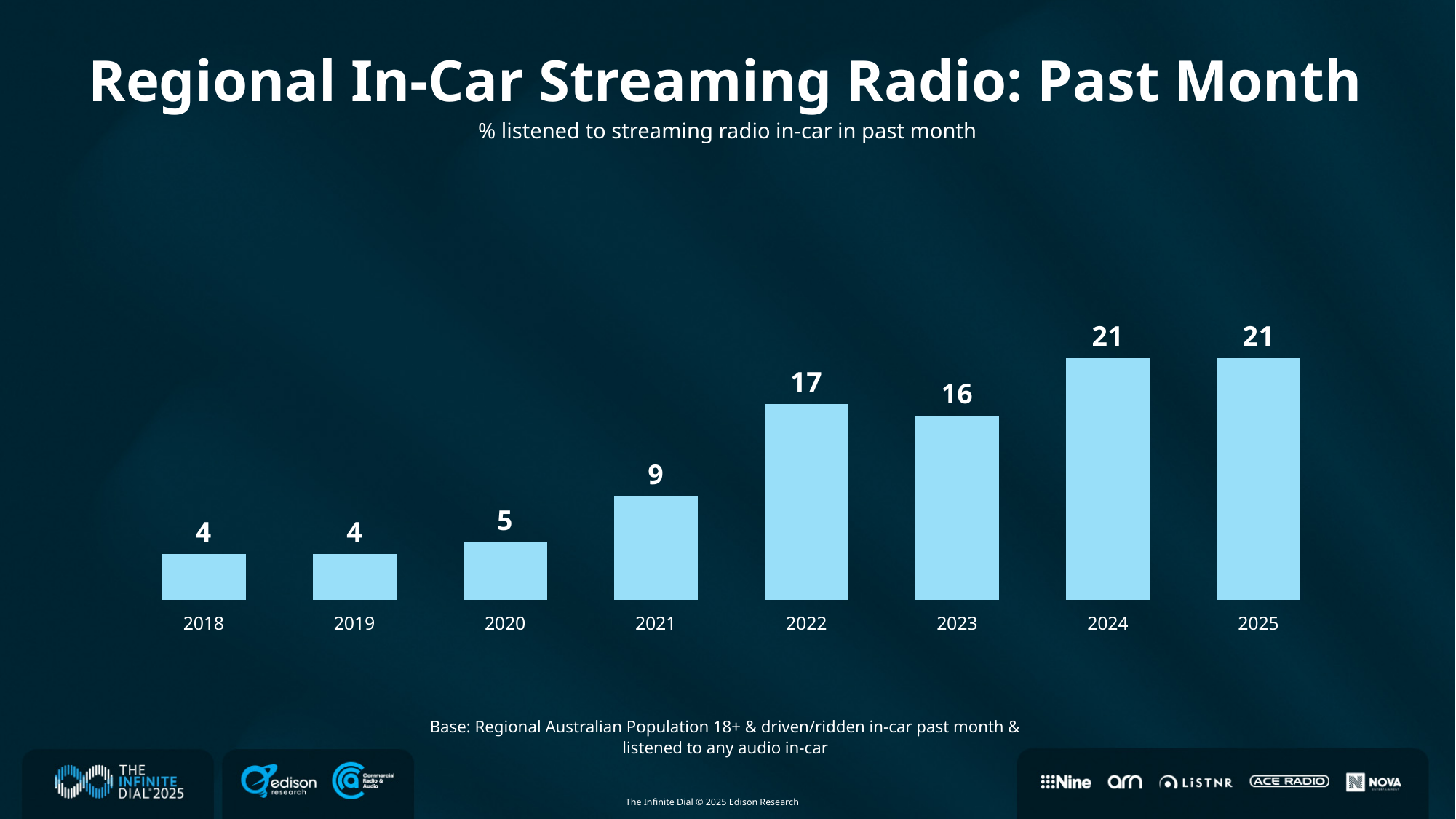
Which is larger, the value for 2022 or the value for 2023? 2022 What is the value for 2022? 17 What is the difference between the values for 2025 and 2018? 17 Which years share the highest value? 2024 and 2025 What is the difference between the values for 2022 and 2021? 8 Which year has the lowest value? 2018 and 2019 What is the value for 2018? 4 Do the values generally rise or fall from 2018 to 2025? Rise How many years are shown on the x axis? 8 What kind of chart is shown on the slide? Bar chart What is the value for 2023? 16 What is the title of the chart? Regional In-Car Streaming Radio: Past Month